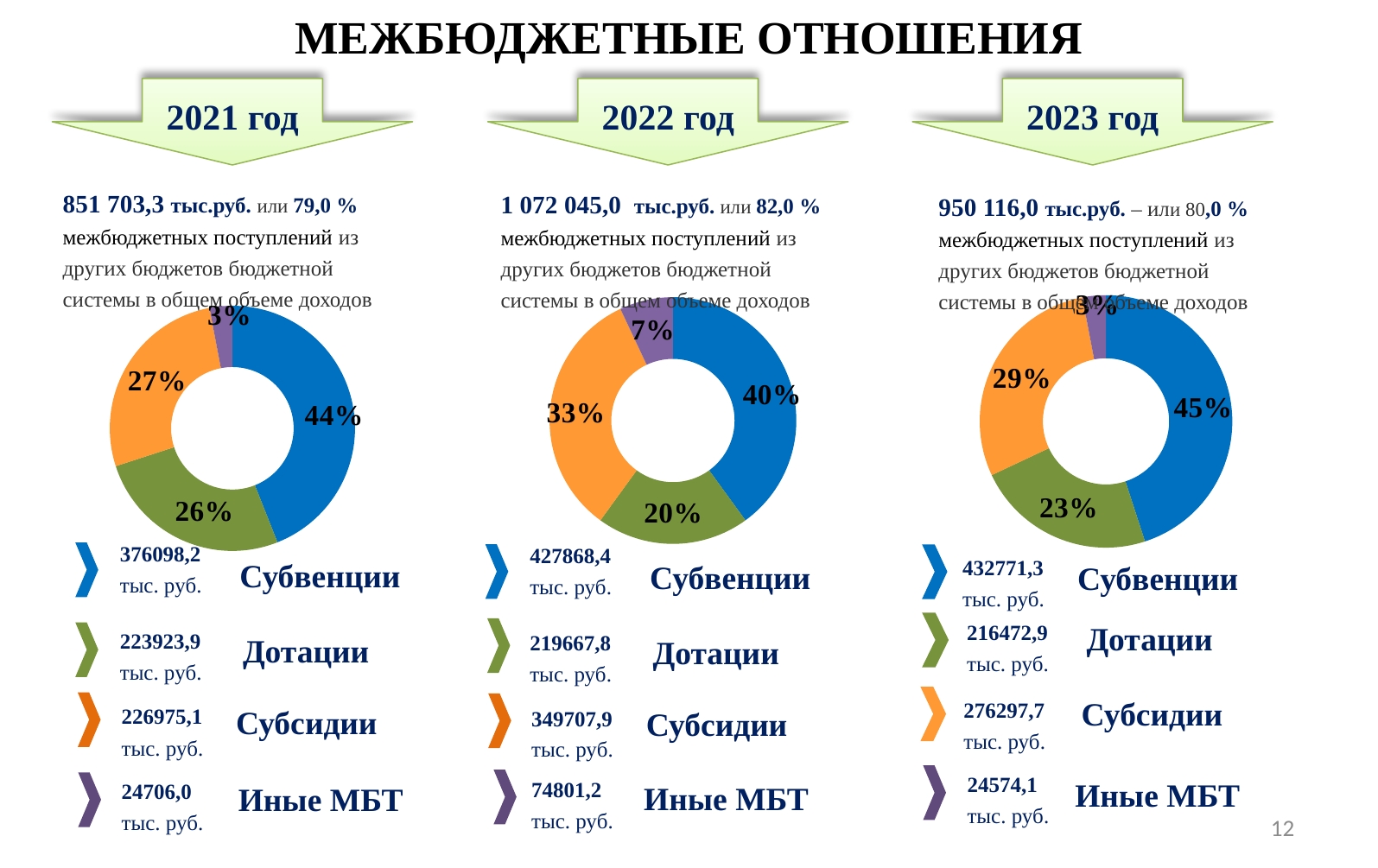
How many slices does the 2022 год chart have? 4 In the 2021 год chart, what colour is the Субвенции slice? Blue In the 2022 год chart, which is larger: Субсидии or Дотации? Субсидии In the 2023 год chart, which category has the largest slice? Субвенции In the 2022 год chart, what share of the pie is Иные МБТ? 7% What kind of chart is used for each year on the slide? Pie (donut) chart In the 2023 год chart, what value in тыс. руб. is listed for Субсидии? 276297,7 In the 2022 год chart, what share of the pie is Субсидии? 33% In the 2021 год chart, what share of the pie is Субвенции? 44% In the 2021 год chart, which category has the smallest slice? Иные МБТ In the 2021 год chart, what is the difference in percentage points between Субвенции and Дотации? 18